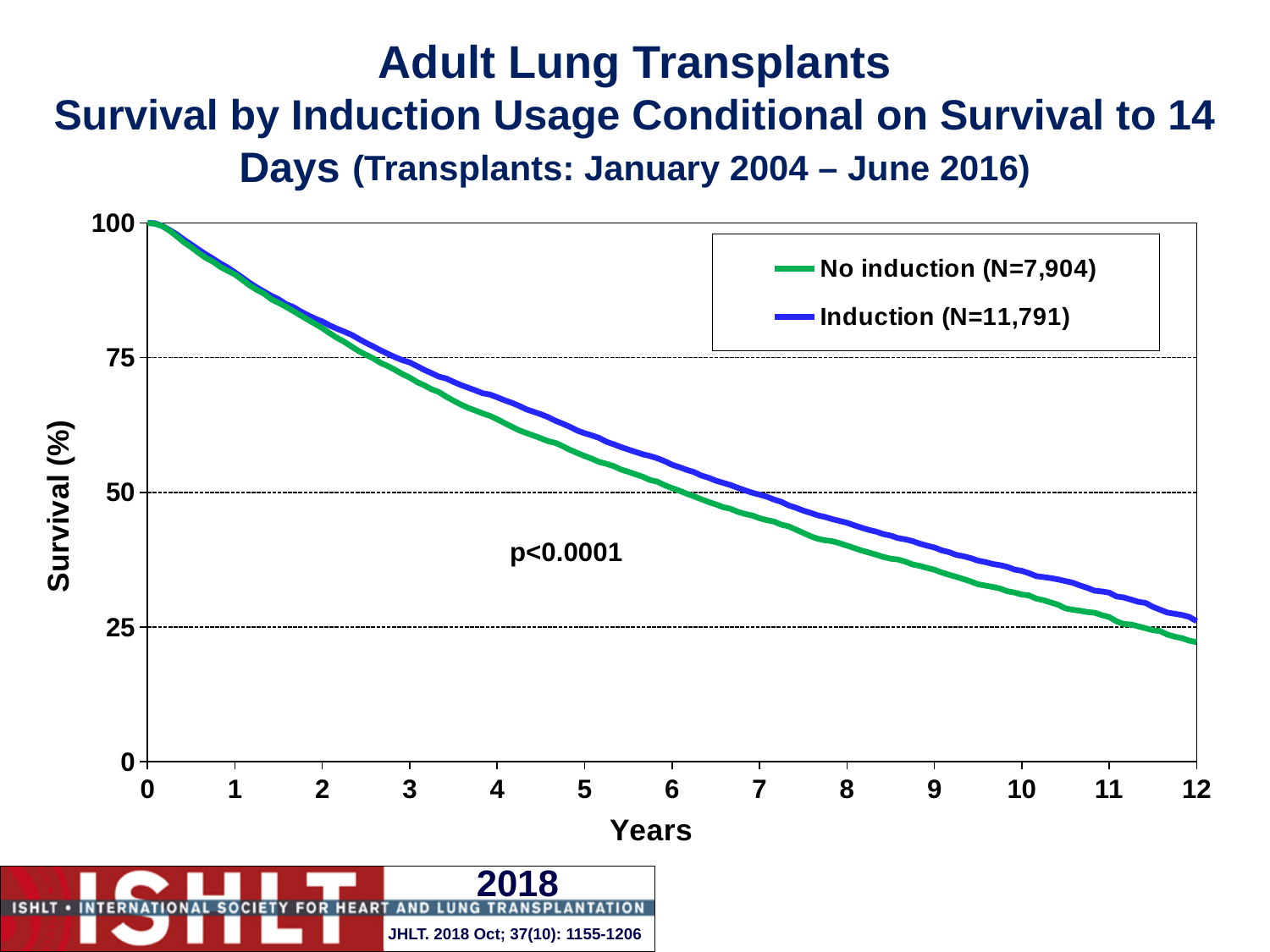
What kind of chart is shown on the slide? line chart Is the survival value for No induction at 12 years greater or less than 25? less Is the survival value for No induction at 2 years greater or less than 75? greater Do the survival curves rise or fall as years increase? fall Is the survival value for Induction at 12 years greater or less than 25? greater How many series does the legend list? 2 What is the N for the No induction group shown in the legend? N=7,904 What p-value is printed on the chart? p<0.0001 At 8 years, which series has the higher survival, Induction or No induction? Induction